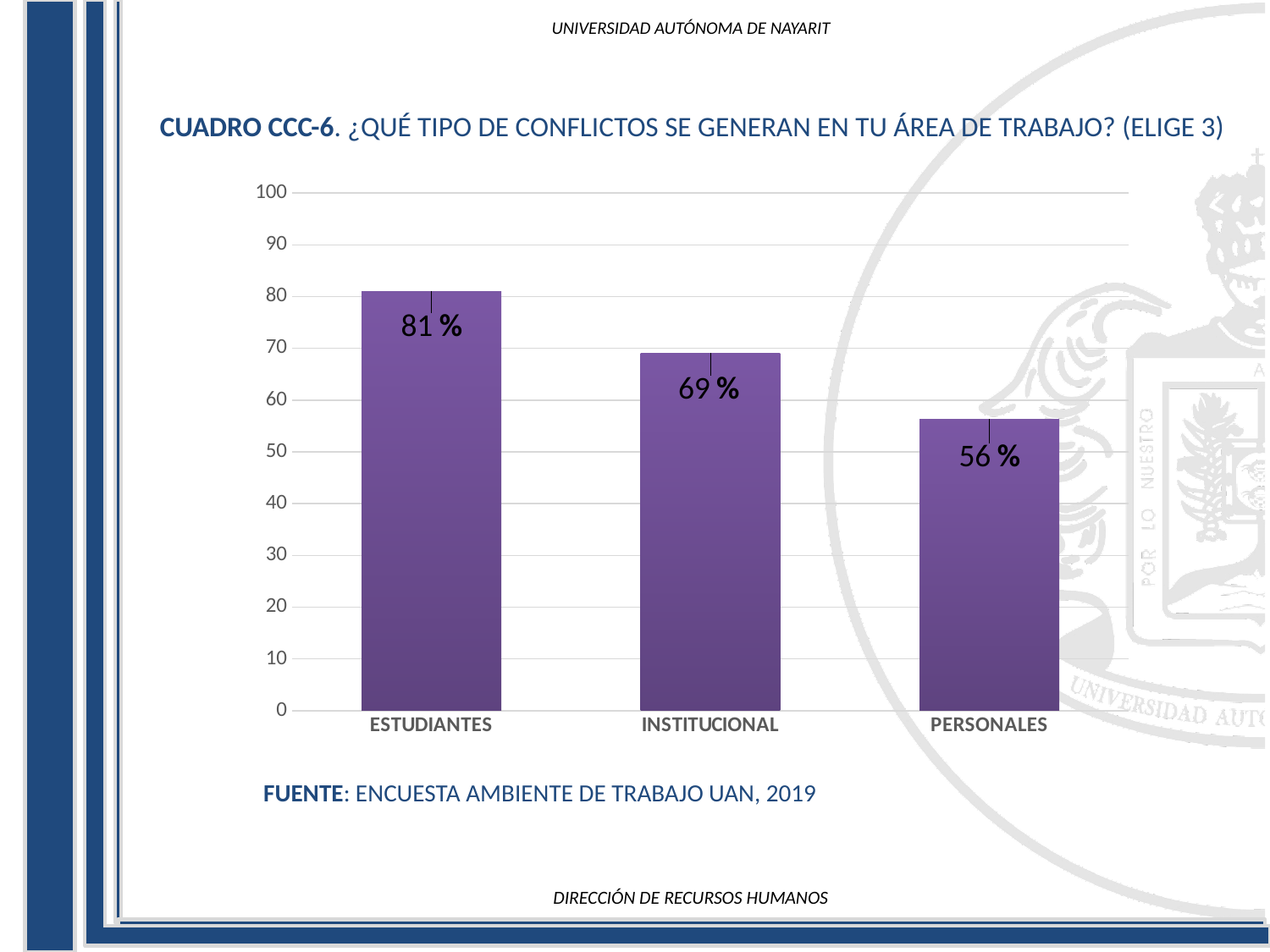
Do the values rise or fall from left to right across the categories? fall What is the value for PERSONALES? 56 % Which category has the highest value? ESTUDIANTES Which is larger, the value for INSTITUCIONAL or the value for PERSONALES? INSTITUCIONAL What is the value for ESTUDIANTES? 81 % Which category has the lowest value? PERSONALES Is the value for PERSONALES greater or less than 60? less What kind of chart is shown on the slide? bar chart What is the difference between the values for ESTUDIANTES and PERSONALES? 25 % What is the value for INSTITUCIONAL? 69 % How many categories are shown in the chart? 3 What is the difference between the values for INSTITUCIONAL and PERSONALES? 13 %